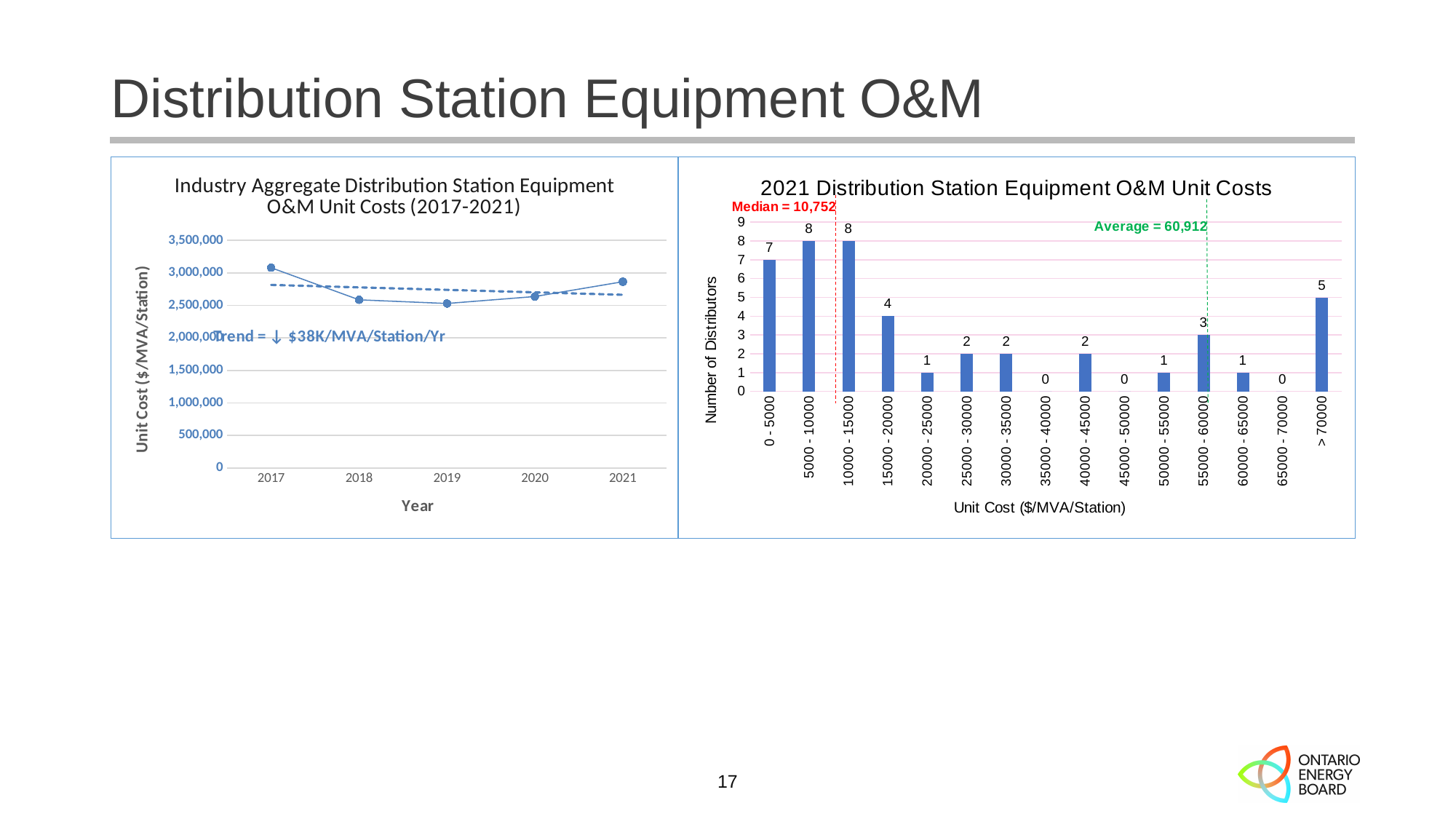
On the right chart (2021 Distribution Station Equipment O&M Unit Costs), how many distributors are in the > 70000 bin? 5 On the right chart (2021 Distribution Station Equipment O&M Unit Costs), how many distributors are in the 55000 - 60000 bin? 3 What kind of chart is the left chart (Industry Aggregate Distribution Station Equipment O&M Unit Costs 2017-2021)? line chart On the left chart (Industry Aggregate Distribution Station Equipment O&M Unit Costs 2017-2021), which year has the highest unit cost? 2017 On the left chart (Industry Aggregate Distribution Station Equipment O&M Unit Costs 2017-2021), how many years are plotted? 5 On the left chart (Industry Aggregate Distribution Station Equipment O&M Unit Costs 2017-2021), is the value for 2019 greater or less than 3,000,000? less On the right chart (2021 Distribution Station Equipment O&M Unit Costs), what average value is annotated? Average = 60,912 On the right chart (2021 Distribution Station Equipment O&M Unit Costs), how many distributors are in the 0 - 5000 bin? 7 On the right chart (2021 Distribution Station Equipment O&M Unit Costs), what is the difference between the number of distributors in the 15000 - 20000 bin and the 20000 - 25000 bin? 3 On the right chart (2021 Distribution Station Equipment O&M Unit Costs), which has more distributors, the 0 - 5000 bin or the > 70000 bin? 0 - 5000 On the right chart (2021 Distribution Station Equipment O&M Unit Costs), what median value is annotated? Median = 10,752 On the right chart (2021 Distribution Station Equipment O&M Unit Costs), how many unit cost bins are shown on the x axis? 15